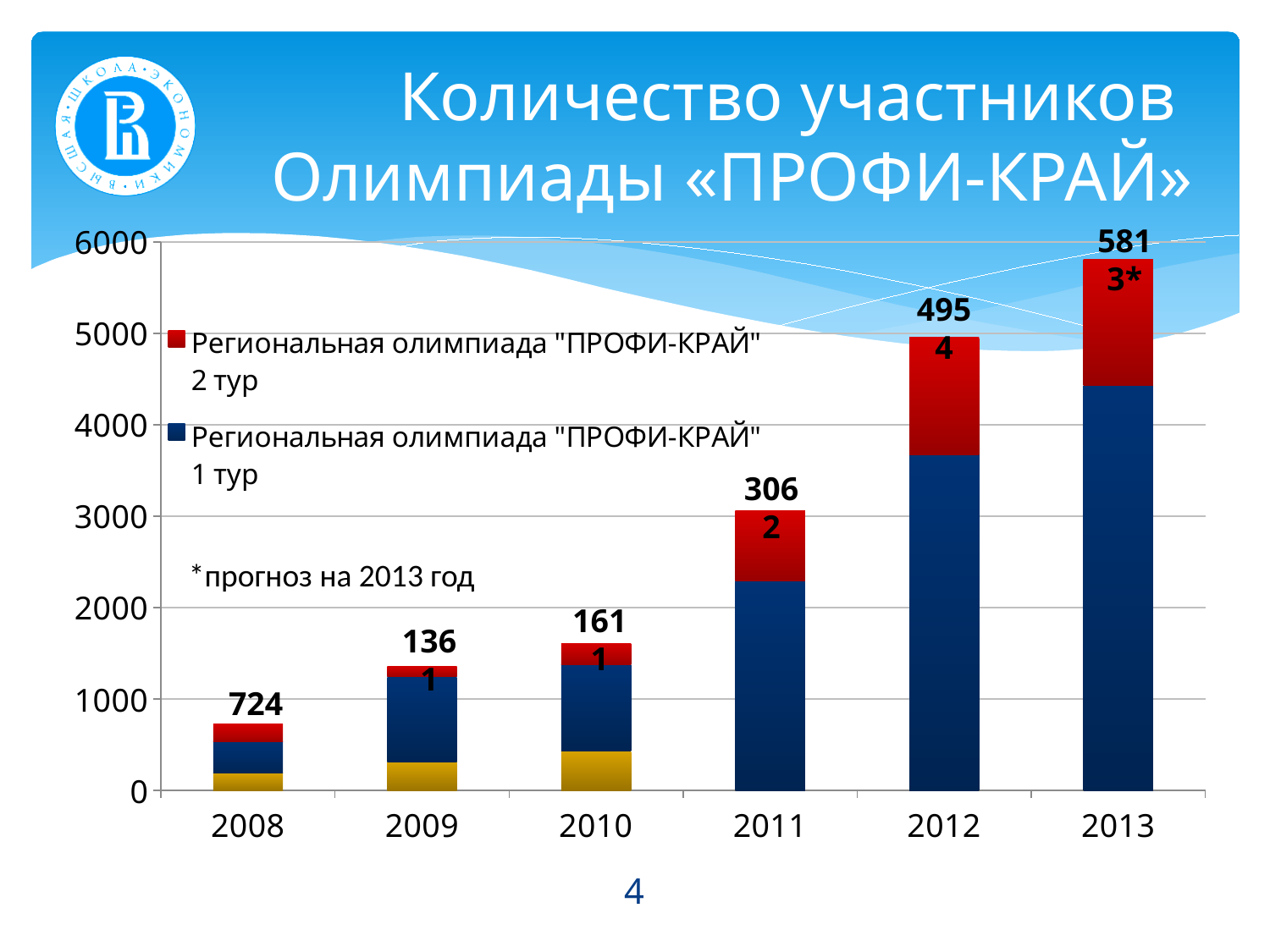
Which bar is taller, 2011 or 2012? 2012 Is the total bar height for 2013 greater or less than 5000? greater Is the total bar height for 2008 greater or less than 1000? less How many series does the chart legend list? 2 Which year has the shortest bar in the chart? 2008 What kind of chart is shown on the slide? Stacked bar chart Is the total bar height for 2012 greater or less than 4000? greater What does the footnote below the legend say the asterisk means? прогноз на 2013 год Which year has the tallest bar in the chart? 2013 Do the bar heights rise or fall from 2008 to 2013? Rise How many years are shown on the x axis of the chart? 6